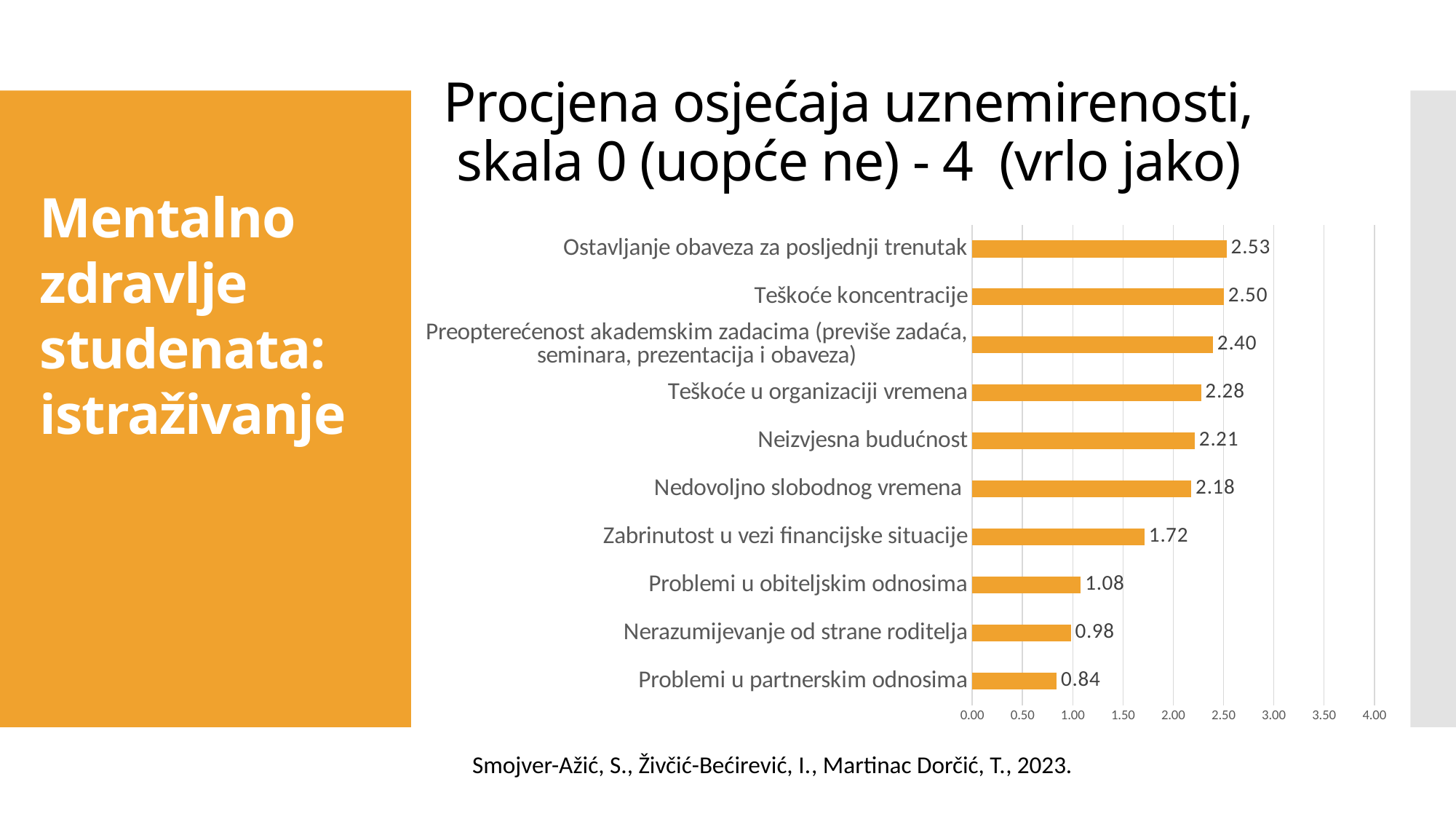
Which is larger: the value for "Nedovoljno slobodnog vremena" or the value for "Zabrinutost u vezi financijske situacije"? Nedovoljno slobodnog vremena What is the difference between the values for "Ostavljanje obaveza za posljednji trenutak" and "Problemi u partnerskim odnosima"? 1.69 What is the title of the chart? Procjena osjećaja uznemirenosti, skala 0 (uopće ne) - 4 (vrlo jako) How many categories are shown in the chart? 10 What is the value for "Neizvjesna budućnost"? 2.21 What is the difference between the values for "Zabrinutost u vezi financijske situacije" and "Problemi u obiteljskim odnosima"? 0.64 What kind of chart is shown on the slide? bar chart Which category has the highest value? Ostavljanje obaveza za posljednji trenutak Is the value for "Nerazumijevanje od strane roditelja" greater or less than 1.00? less What is the value for "Teškoće koncentracije"? 2.50 Which category has the lowest value? Problemi u partnerskim odnosima What is the value for "Problemi u obiteljskim odnosima"? 1.08